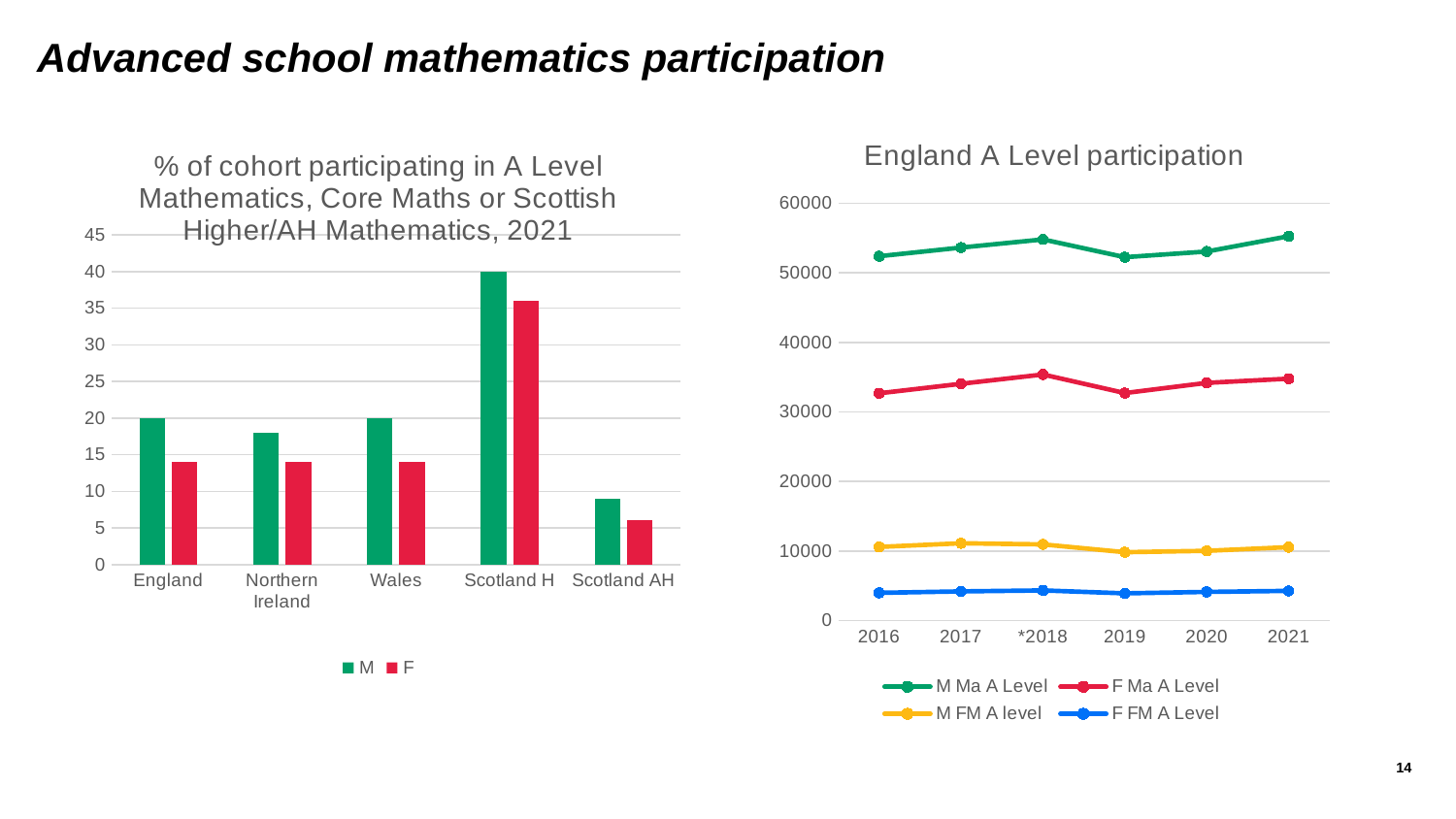
On the left chart, what is the value for M in England? 20 On the left chart, how many categories are shown on the x axis? 5 On the left chart, is the value for M in Scotland AH greater or less than 10? less On the left chart, which category has the lowest F value? Scotland AH On the left chart, what kind of chart is it? bar chart On the left chart, which category has the highest M value? Scotland H On the right chart, how many series does the legend list? 4 On the right chart, is the value for M Ma A Level in 2021 greater or less than 50000? greater On the right chart, which series has the highest values across all years? M Ma A Level On the left chart, is the value for F in Scotland H greater or less than 30? greater On the left chart, what is the value for M in Scotland H? 40